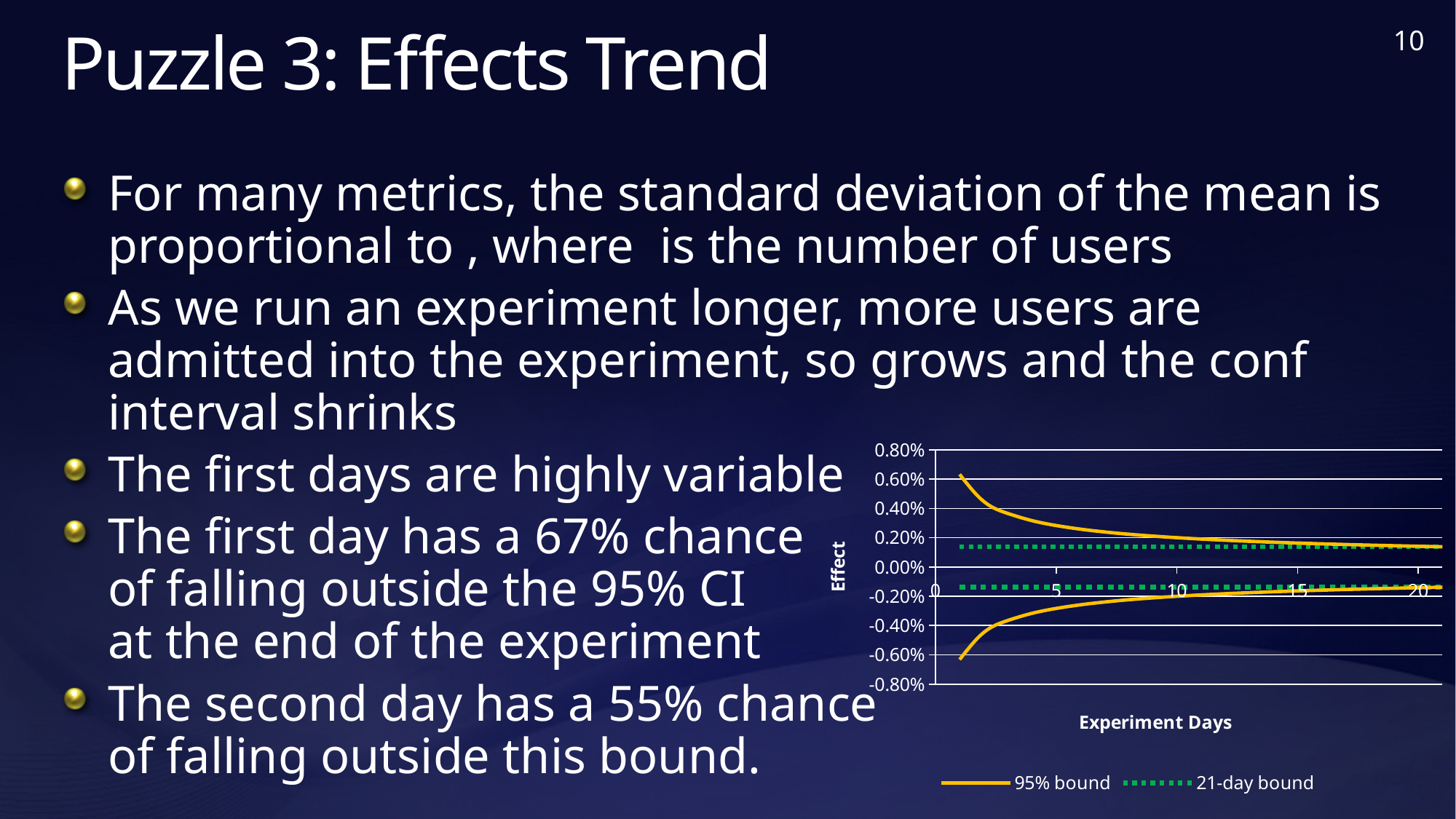
What kind of chart is shown on the slide? line chart Is the lower 95% bound at day 1 greater or less than -0.40%? less Which series is drawn as a dotted line in the chart? 21-day bound What are the two series named in the chart legend? 95% bound and 21-day bound Does the lower 95% bound line rise or fall as Experiment Days increase? rise Is the upper 95% bound at day 20 greater or less than 0.40%? less At day 5, which is larger: the upper 95% bound or the upper 21-day bound? the upper 95% bound How many series does the chart legend list? 2 What is the title of the chart's x axis? Experiment Days Is the upper 21-day bound greater or less than 0.20%? less Does the upper 95% bound line rise or fall as Experiment Days increase? fall